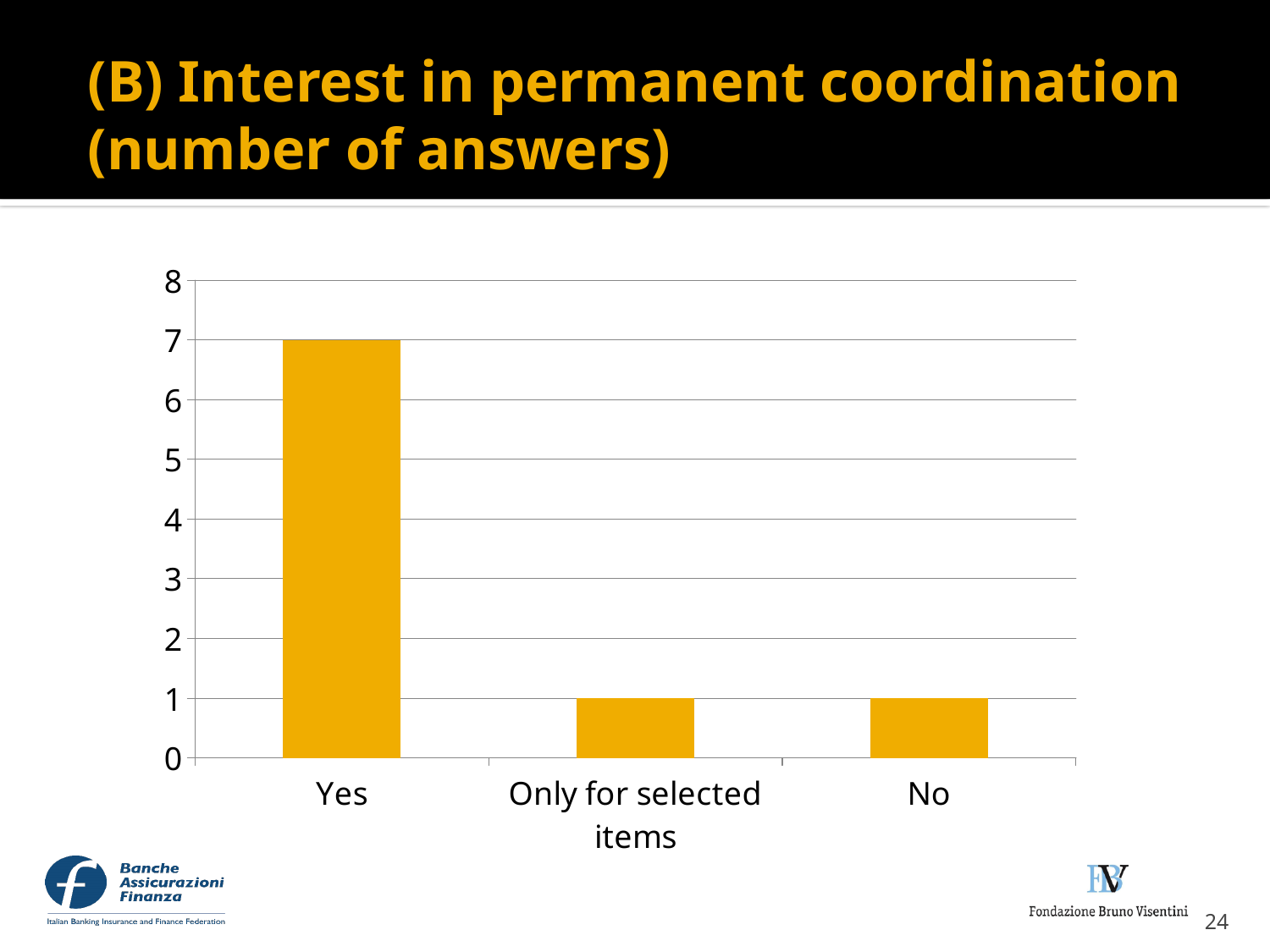
Which is larger, the value for Yes or the value for No? Yes What is the value for No? 1 Is the value for Yes greater or less than 5? greater Which category has the highest value? Yes Is the value for No greater or less than 4? less What is the difference between the values for Yes and Only for selected items? 6 What kind of chart is shown on the slide? bar chart How many categories are shown on the x axis? 3 What is the title of the slide containing the chart? (B) Interest in permanent coordination (number of answers) What is the value for Yes? 7 What is the value for Only for selected items? 1 What is the difference between the values for Yes and No? 6